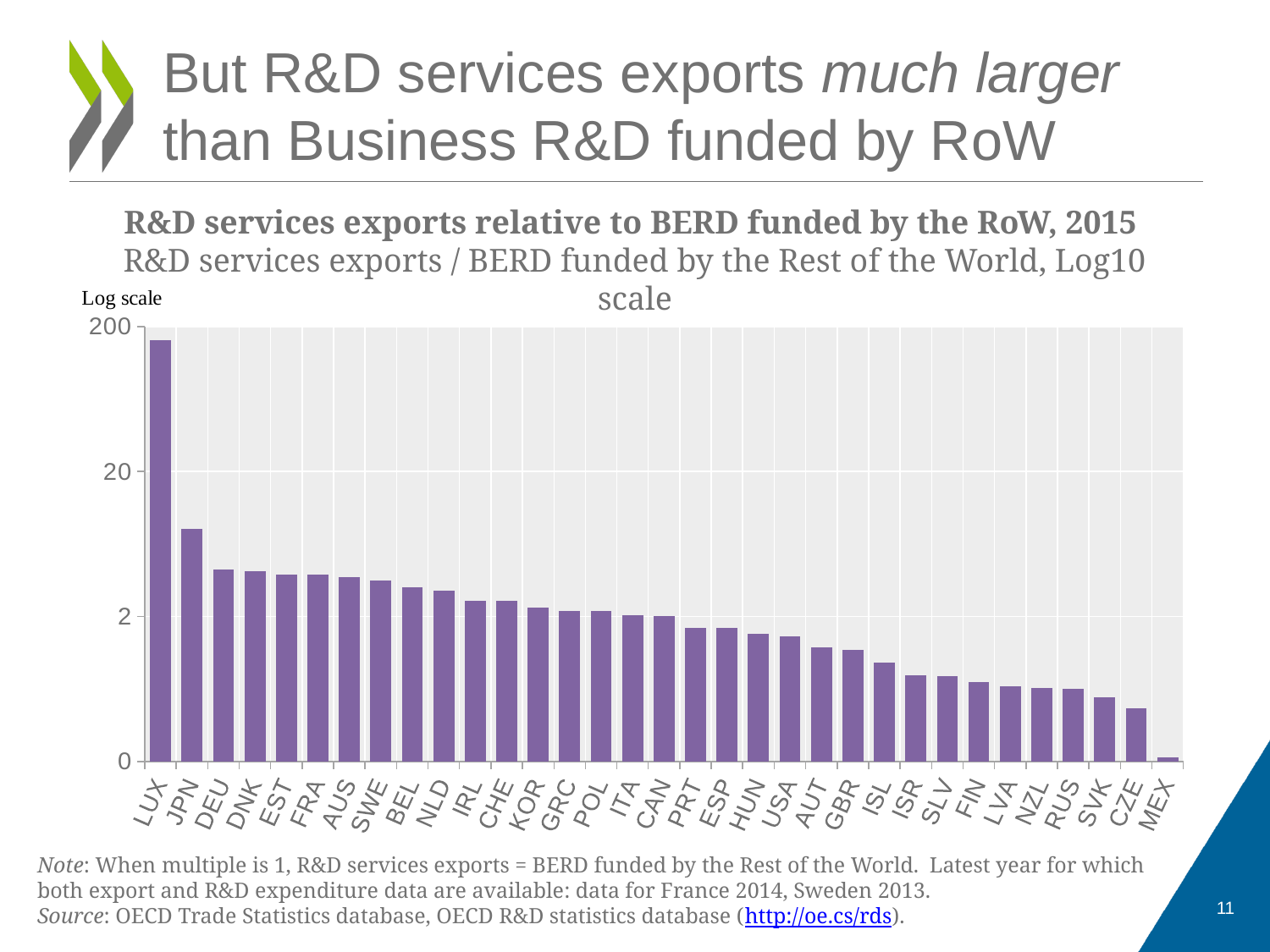
Which has the larger value, LUX or JPN? LUX Is the value for CZE greater or less than 2? less Is the value for JPN greater or less than 20? less Do the bar values rise or fall moving from left to right along the x axis? fall Which country has the lowest value in the chart? MEX Is the value for MEX greater or less than 2? less Which country has the highest value in the chart? LUX What kind of chart is shown on the slide? bar chart Which has the larger value, JPN or DEU? JPN How many countries are shown on the x axis of the chart? 33